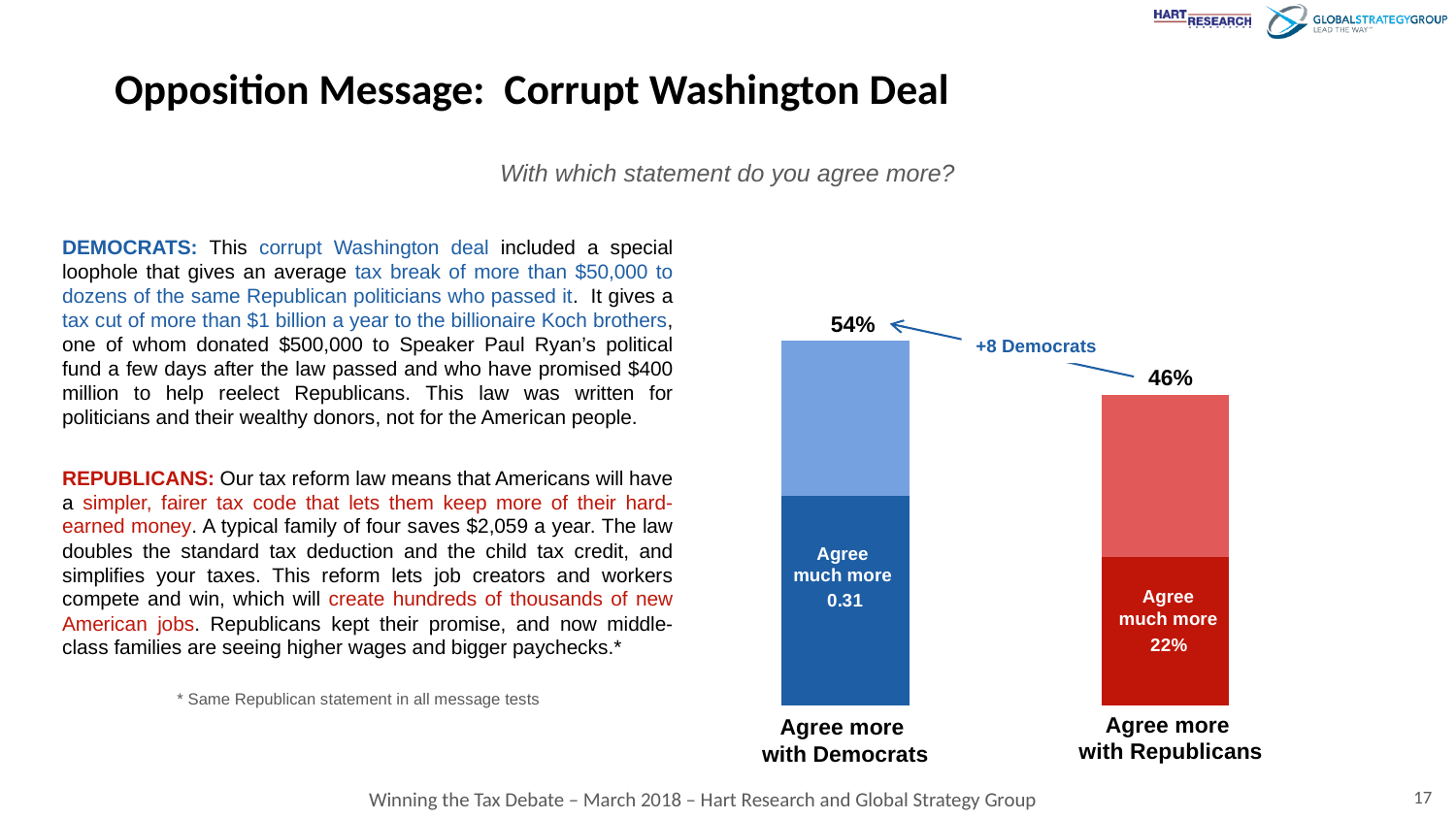
What does the annotation between the two bars say? +8 Democrats How many bars are shown in the chart? 2 What percentage agrees more with Democrats in total? 54% Which bar is taller, Agree more with Democrats or Agree more with Republicans? Agree more with Democrats Is the total for Agree more with Democrats larger or smaller than the total for Agree more with Republicans? Larger What is the difference between the Agree more with Democrats total and the Agree more with Republicans total? 8 points Which bar has the lower total value? Agree more with Republicans What percentage agrees more with Republicans in total? 46% What value is printed for the 'Agree much more' segment of the Agree more with Democrats bar? 0.31 What value is printed for the 'Agree much more' segment of the Agree more with Republicans bar? 22% What kind of chart is shown on the slide? Stacked bar chart What colour is the Agree more with Republicans bar? Red